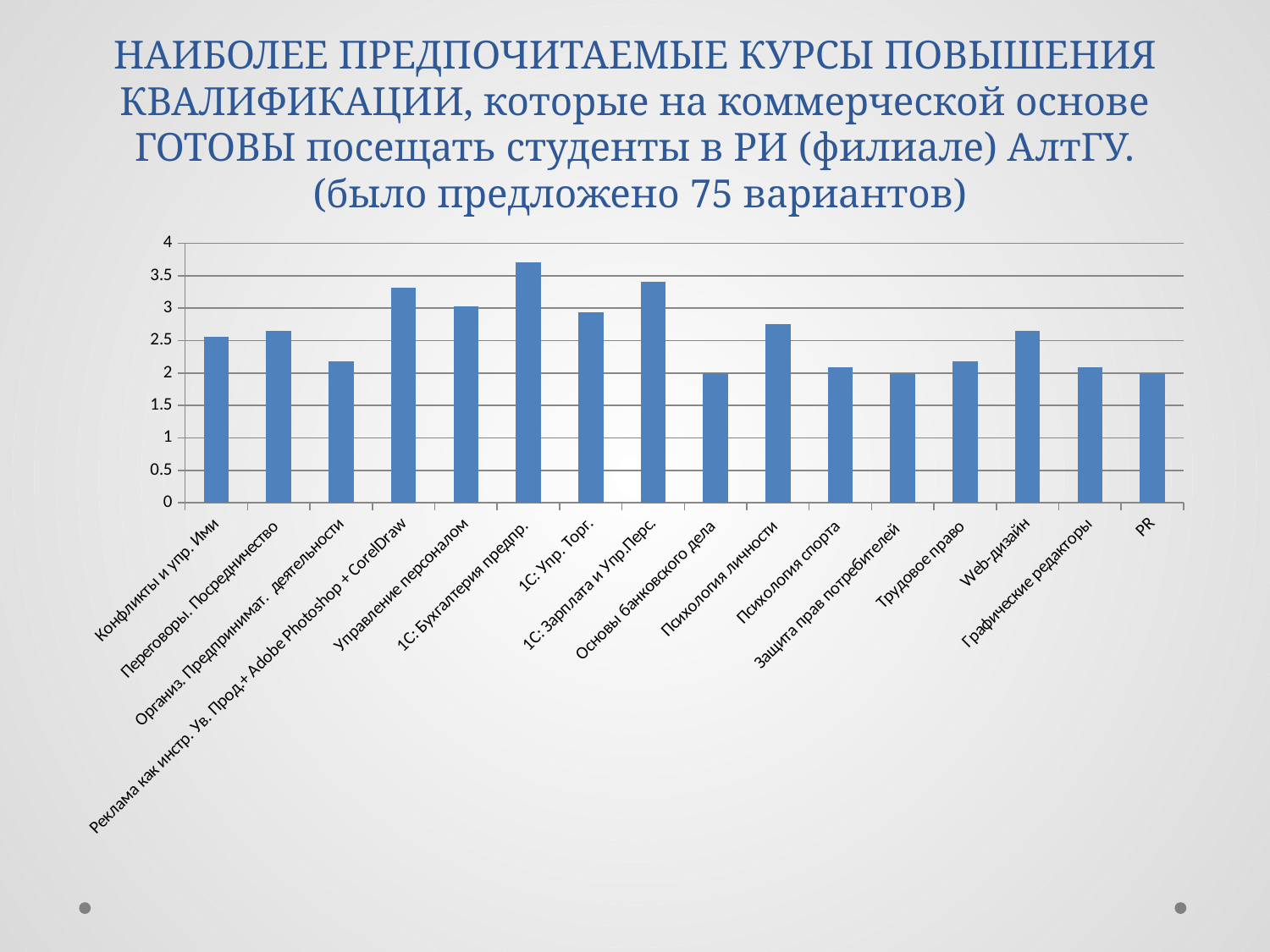
Which is larger, the value for Психология личности or the value for Психология спорта? Психология личности Is the value for Психология личности greater or less than 2.5? greater According to the slide title, how many course options were offered to the students? 75 What is the maximum value shown on the vertical axis of the chart? 4 Is the value for 1С: Бухгалтерия предпр. greater or less than 3.5? greater Is the value for Реклама как инстр. Ув. Прод + Adobe Photoshop + CorelDraw greater or less than 3? greater Which course has the highest bar on the chart? 1С: Бухгалтерия предпр. How many categories (courses) are plotted on the chart? 16 What kind of chart is shown on the slide? bar chart Which is larger, the value for 1С: Бухгалтерия предпр. or the value for 1С: Зарплата и Упр.Перс.? 1С: Бухгалтерия предпр.